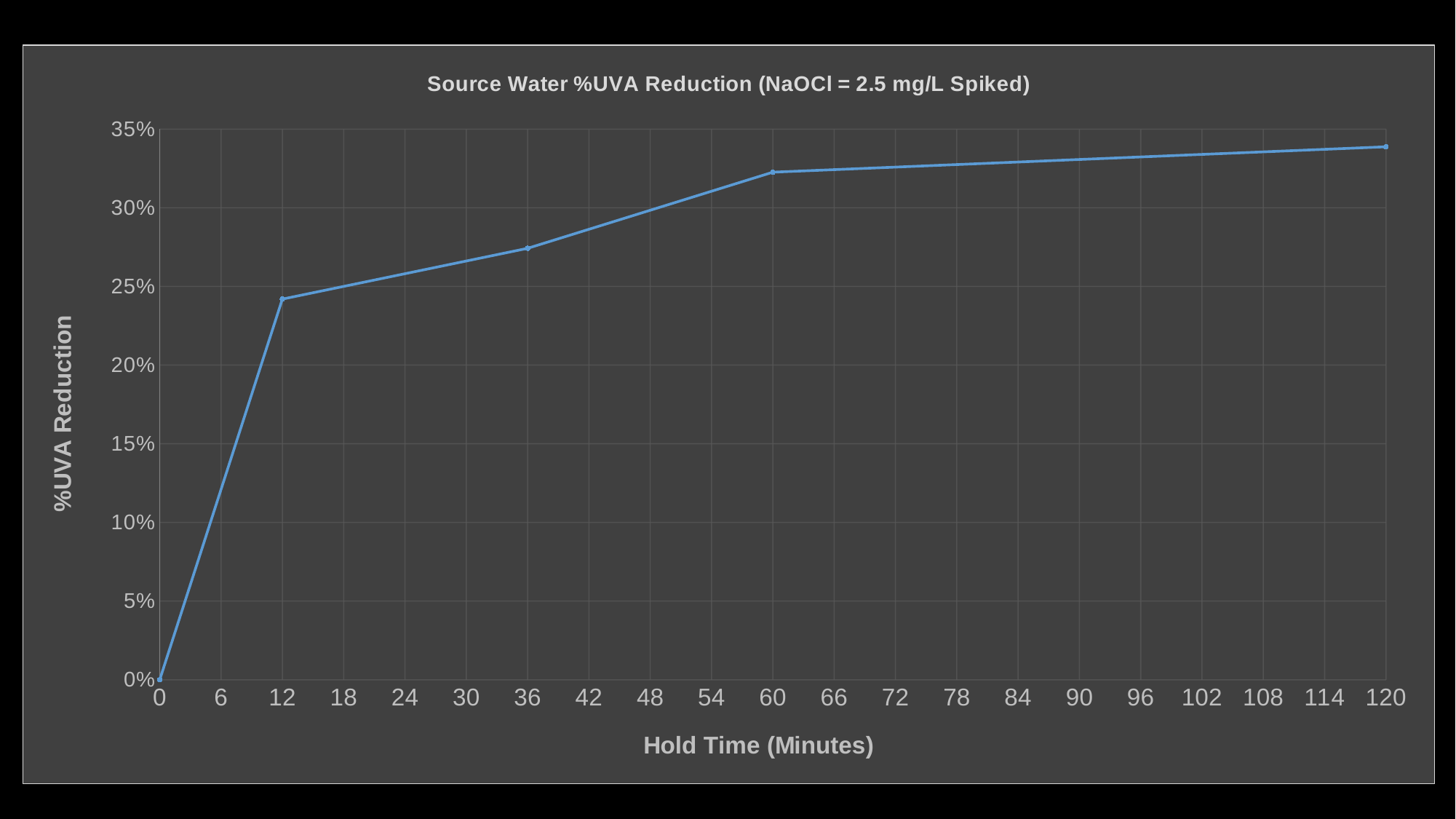
What is the label of the x axis? Hold Time (Minutes) What kind of chart is shown on the slide? line chart Is the %UVA Reduction at 60 minutes greater or less than 30%? greater How many data points are plotted on the line? 5 At which hold time is the %UVA Reduction highest? 120 Is the %UVA Reduction at 12 minutes greater or less than 20%? greater Is the %UVA Reduction at 36 minutes greater or less than 30%? less What is the title of the chart? Source Water %UVA Reduction (NaOCl = 2.5 mg/L Spiked) At which hold time is the %UVA Reduction lowest? 0 Do the values rise or fall as hold time increases along the x axis? rise What is the %UVA Reduction at a hold time of 0 minutes? 0% Which has a higher %UVA Reduction, a hold time of 12 minutes or 60 minutes? 60 minutes